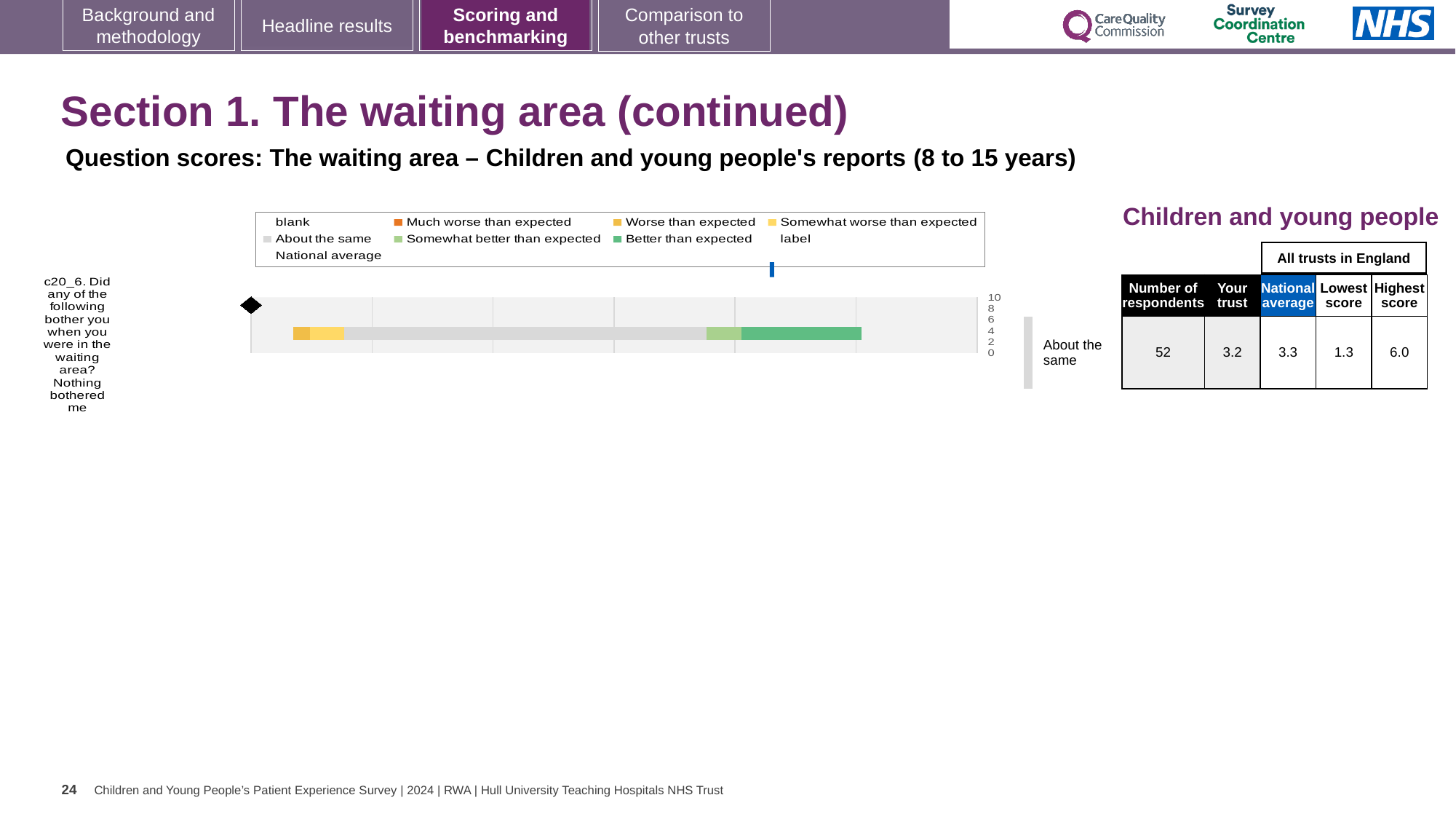
How many survey questions (categories) are plotted on the chart? 1 What is the difference between the highest score and the lowest score for question c20_6? 4.7 What is the 'Your trust' score for question c20_6 in the table? 3.2 Which is larger for question c20_6: the 'Your trust' score or the national average? National average What is the highest value shown on the chart's axis? 10 Which legend entry is shown in dark green? Better than expected How many respondents answered question c20_6? 52 How many entries does the chart legend list? 9 What kind of chart is shown on the slide? bar chart What is the lowest score among all trusts in England for question c20_6? 1.3 What is the national average score for question c20_6? 3.3 What is the highest score among all trusts in England for question c20_6? 6.0